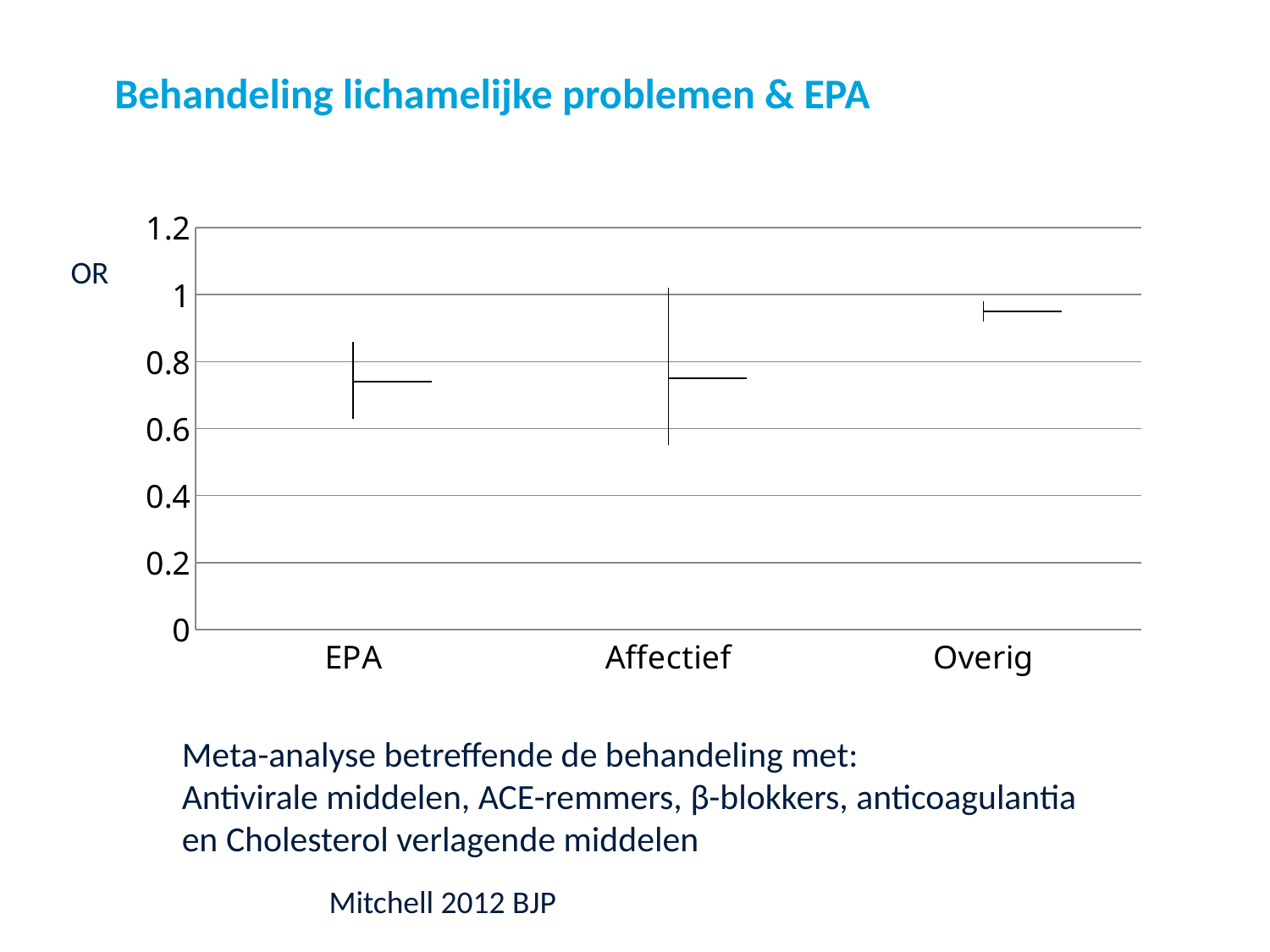
What is the title of the slide containing the chart? Behandeling lichamelijke problemen & EPA Which has a larger OR value, Overig or EPA? Overig Which category has the highest OR value in the chart? Overig How many categories are shown on the x axis of the chart? 3 What is the highest value shown on the y axis of the chart? 1.2 Which has a larger OR value, Affectief or Overig? Overig Is the OR value for Affectief greater or less than 0.6? greater Is the OR value for Overig greater or less than 0.8? greater Is the OR value for EPA greater or less than 0.8? less What is the label on the y axis of the chart? OR